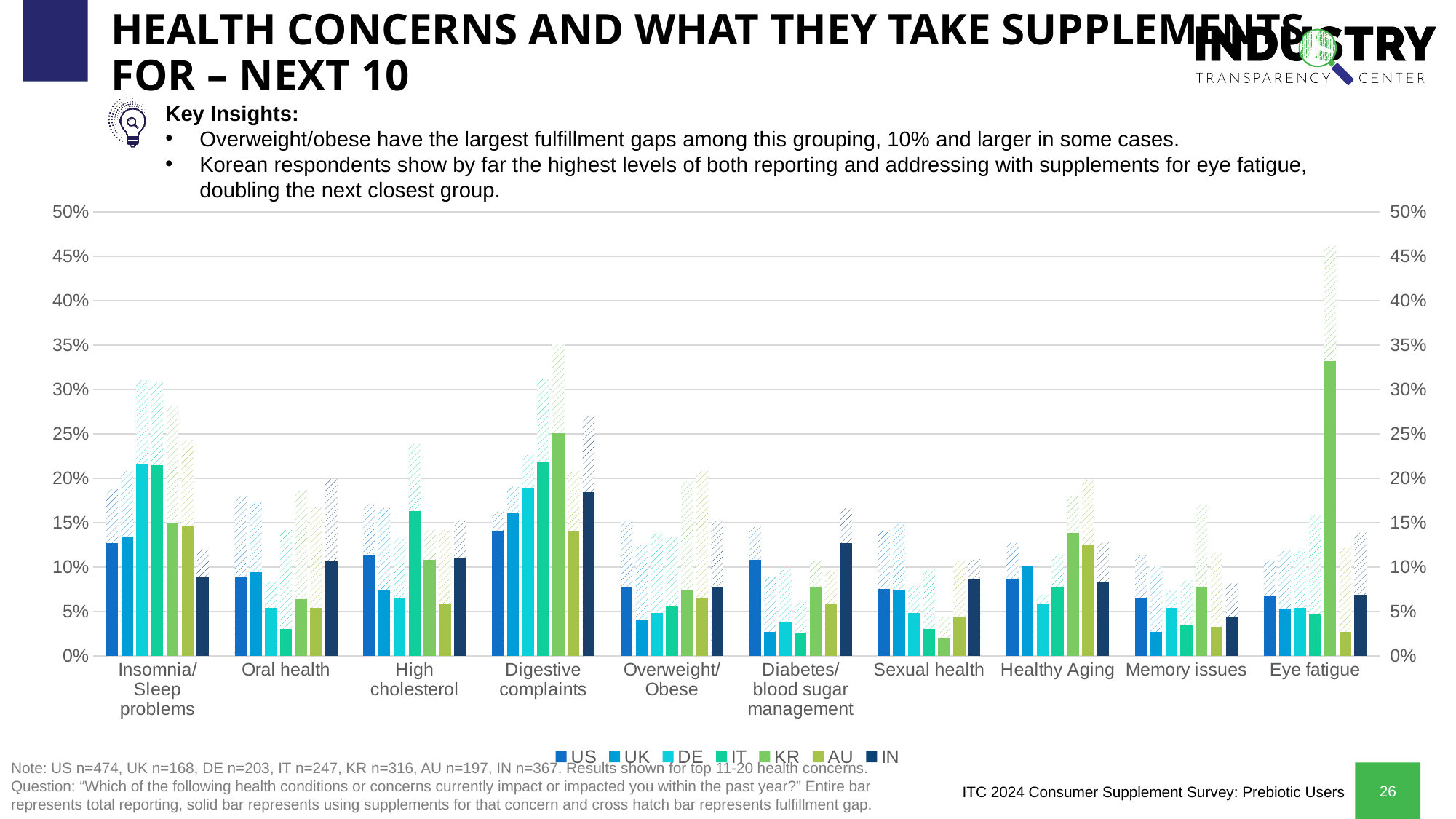
Is the solid IT bar for Oral health greater or less than 5%? less Is the solid KR bar for Eye fatigue greater or less than 30%? greater How many health concern categories are shown on the x axis? 10 Which series is listed last in the legend? IN Which series has the tallest solid bar for Eye fatigue? KR For Digestive complaints, which solid bar is taller: KR or US? KR How many series does the legend list? 7 Which series has the shortest solid bar for Eye fatigue? AU What kind of chart is shown on the slide? bar chart Which series has the tallest solid bar for Diabetes/blood sugar management? IN Is the solid KR bar for Digestive complaints greater or less than 20%? greater Which series has the tallest solid bar for Digestive complaints? KR